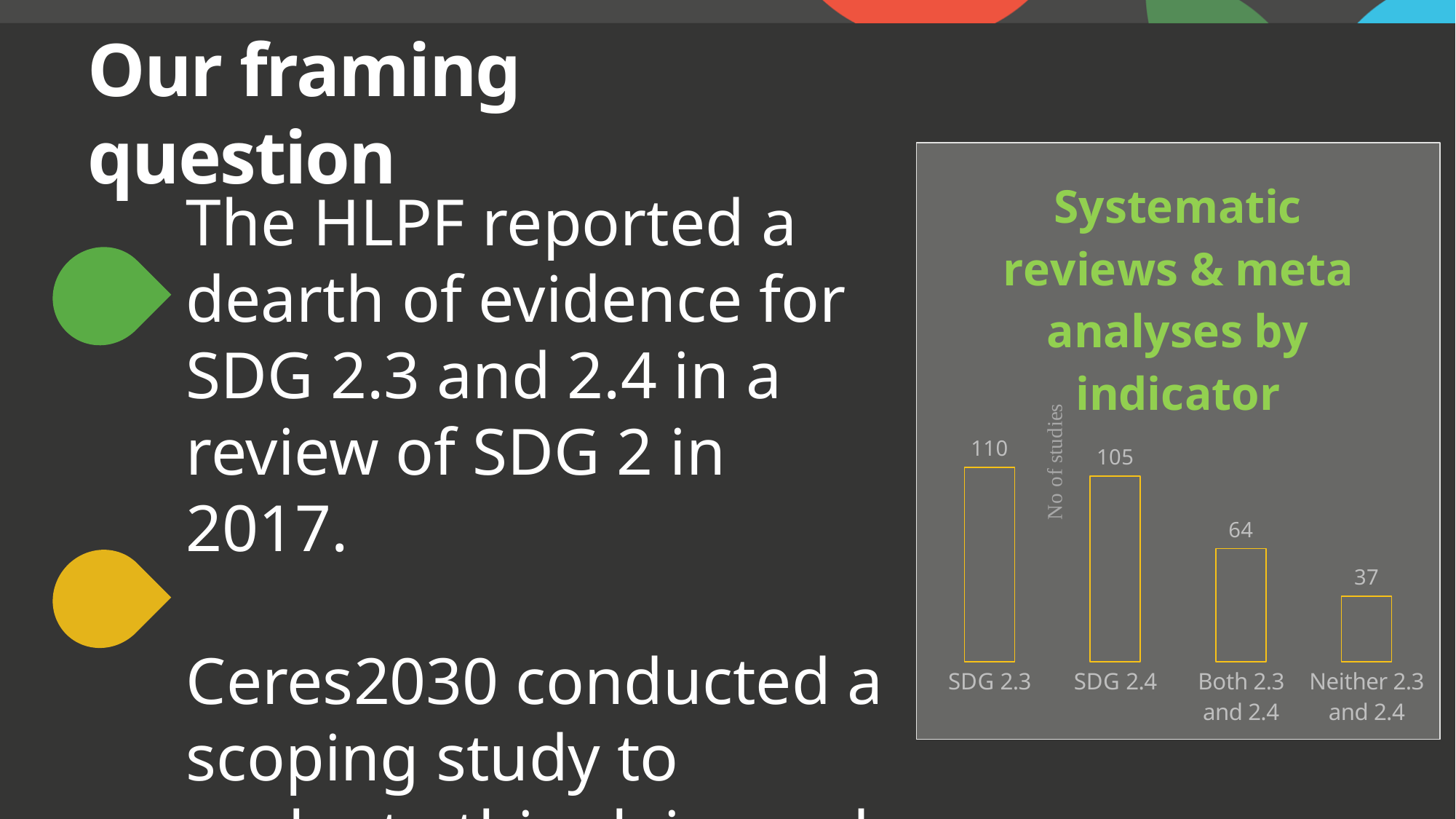
Which has more studies, SDG 2.4 or Both 2.3 and 2.4? SDG 2.4 What is the difference between the number of studies for Both 2.3 and 2.4 and Neither 2.3 and 2.4? 27 What is the title of the chart? Systematic reviews & meta analyses by indicator What is the number of studies for SDG 2.3? 110 Which category has the lowest number of studies? Neither 2.3 and 2.4 What kind of chart is shown on the slide? Bar chart What is the number of studies for Both 2.3 and 2.4? 64 Which category has the highest number of studies? SDG 2.3 What is the difference between the number of studies for SDG 2.3 and SDG 2.4? 5 What is the number of studies for Neither 2.3 and 2.4? 37 How many categories are shown in the chart? 4 What is the number of studies for SDG 2.4? 105